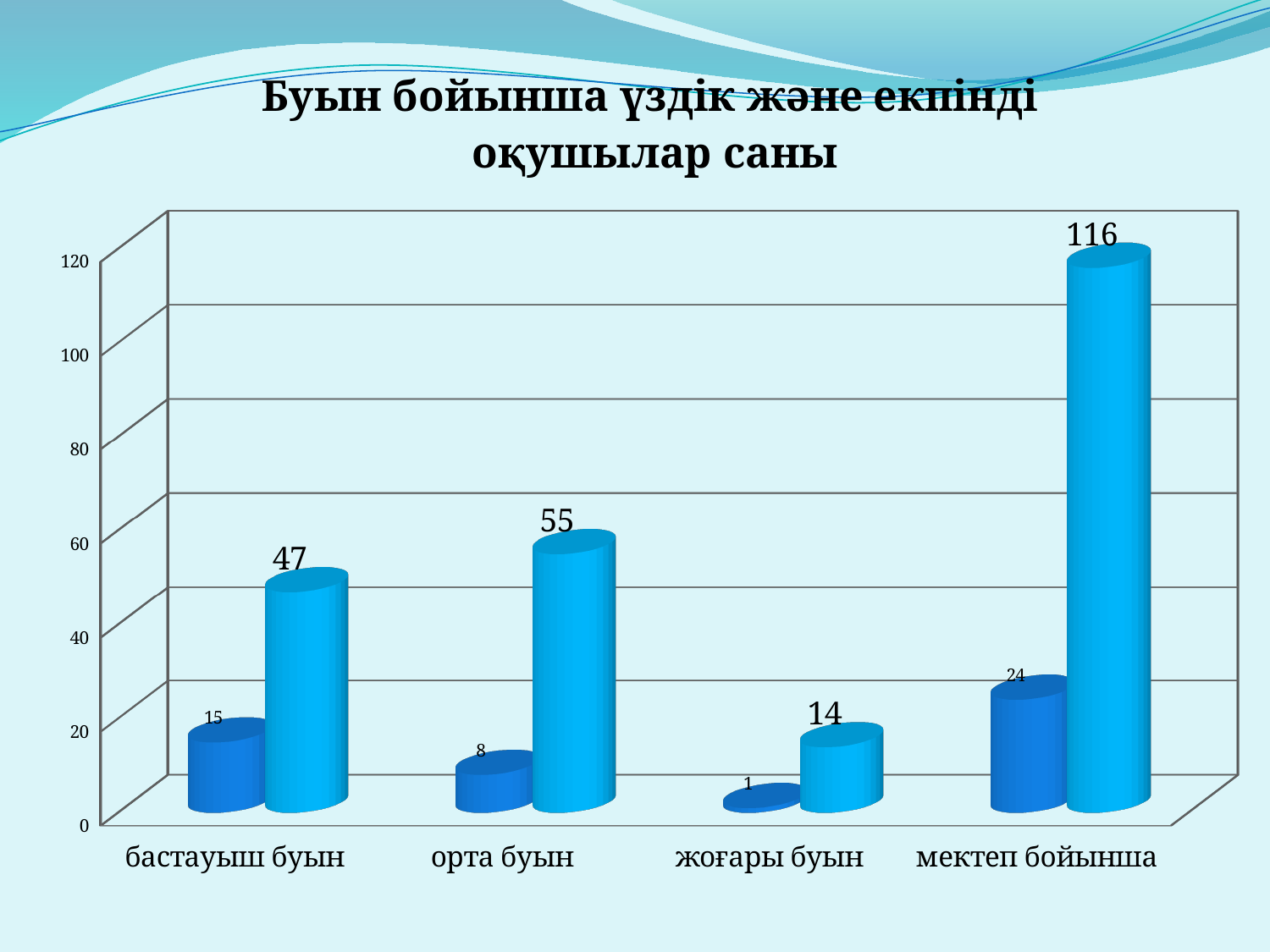
Which category has the lowest dark blue bar? жоғары буын What is the title of the chart? Буын бойынша үздік және екпінді оқушылар саны What is the value of the dark blue bar for жоғары буын? 1 What is the value of the shorter (dark blue) bar for бастауыш буын? 15 What is the difference between the light blue and dark blue bars for орта буын? 47 How many categories are shown on the x axis? 4 Which is larger: the light blue bar for бастауыш буын or the light blue bar for орта буын? орта буын Is the light blue bar for мектеп бойынша greater or less than 100? greater What kind of chart is shown on the slide? bar chart What is the value of the taller (light blue) bar for мектеп бойынша? 116 Which category has the highest light blue bar? мектеп бойынша What is the value of the light blue bar for орта буын? 55